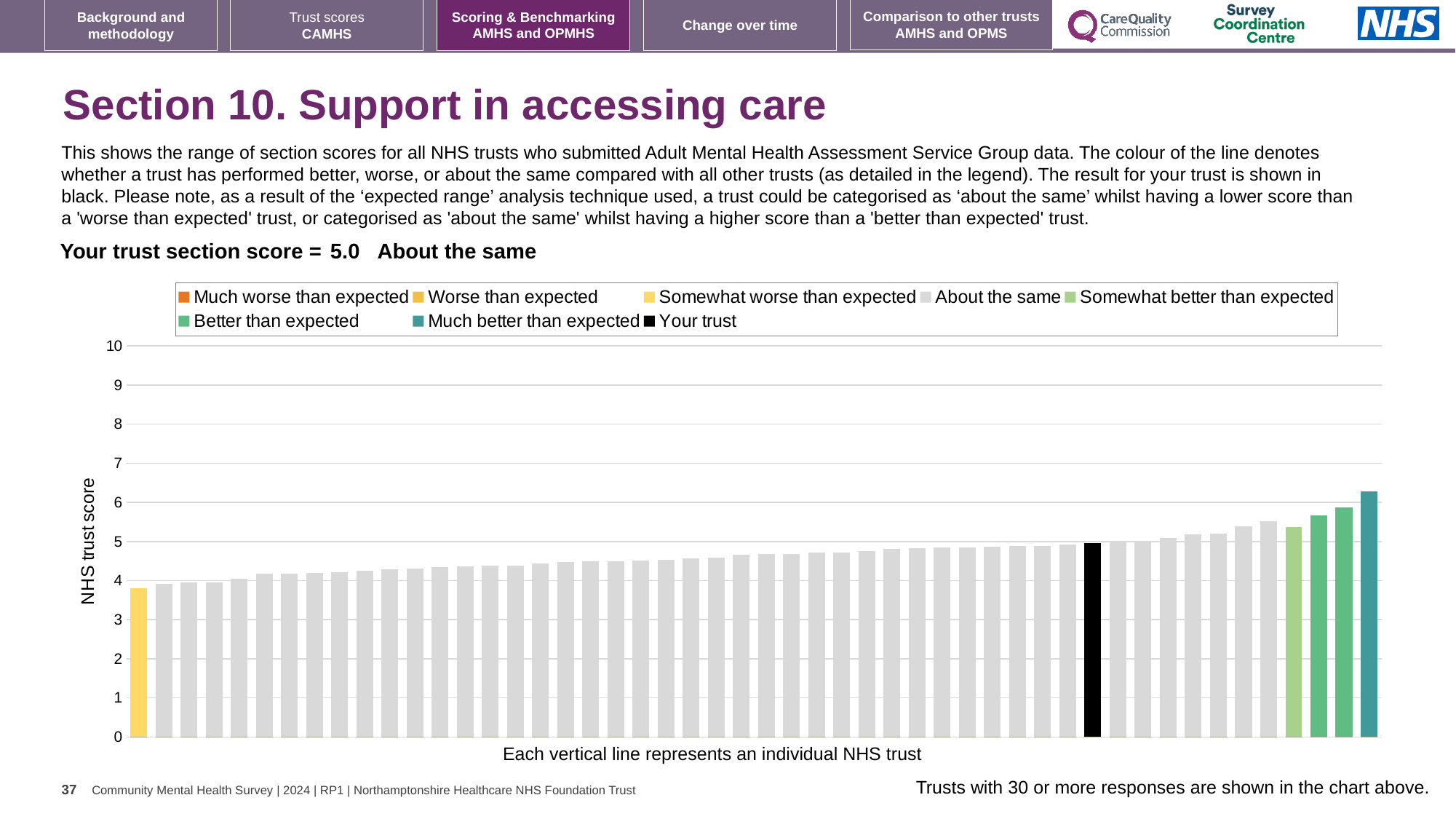
What is the section score for your trust, as printed on the slide? 5.0 What colour is the bar representing your trust? black What is the label on the vertical axis of the chart? NHS trust score Which is larger: the value of the black 'Your trust' bar or the value of the rightmost teal bar? the rightmost teal bar What kind of chart is shown on the slide? bar chart Is the value of the tallest bar (the rightmost, teal bar) greater or less than 6? greater How many entries does the chart legend list? 8 Is the value of the black 'Your trust' bar greater or less than 4? greater Is the value of the black 'Your trust' bar greater or less than 6? less Which category does your trust fall into according to the text above the chart? About the same Do the bar values rise or fall from left to right along the x axis? rise